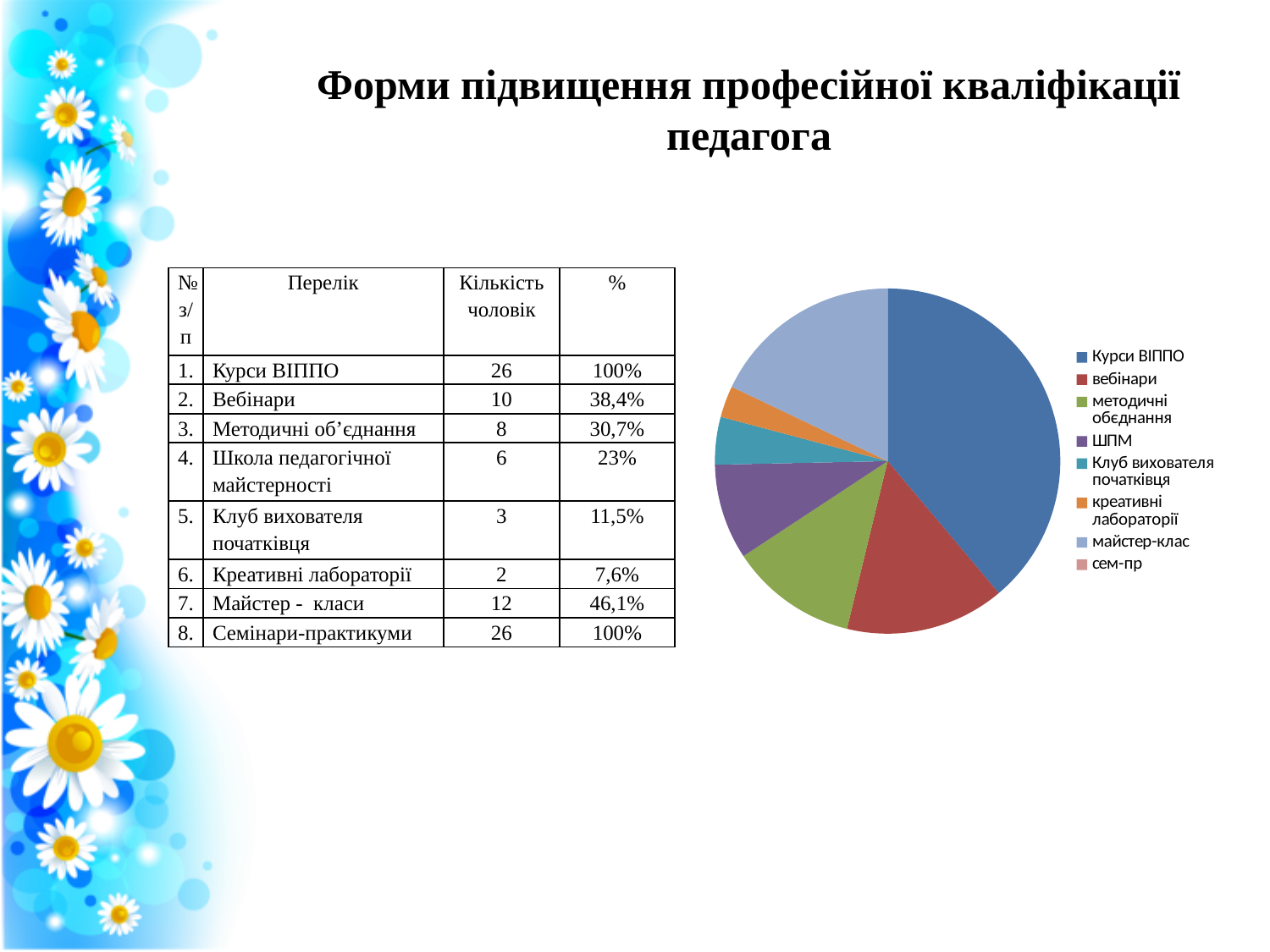
Which slice is larger in the pie chart, Курси ВІППО or вебінари? Курси ВІППО What kind of chart is shown on the slide? pie chart What colour is the Курси ВІППО slice in the pie chart? blue Which slice is larger in the pie chart, Курси ВІППО or майстер-клас? Курси ВІППО Which slice is larger in the pie chart, майстер-клас or ШПМ? майстер-клас How many entries does the legend of the pie chart list? 8 What is the first entry listed in the pie chart's legend? Курси ВІППО Which category has the largest slice in the pie chart? Курси ВІППО